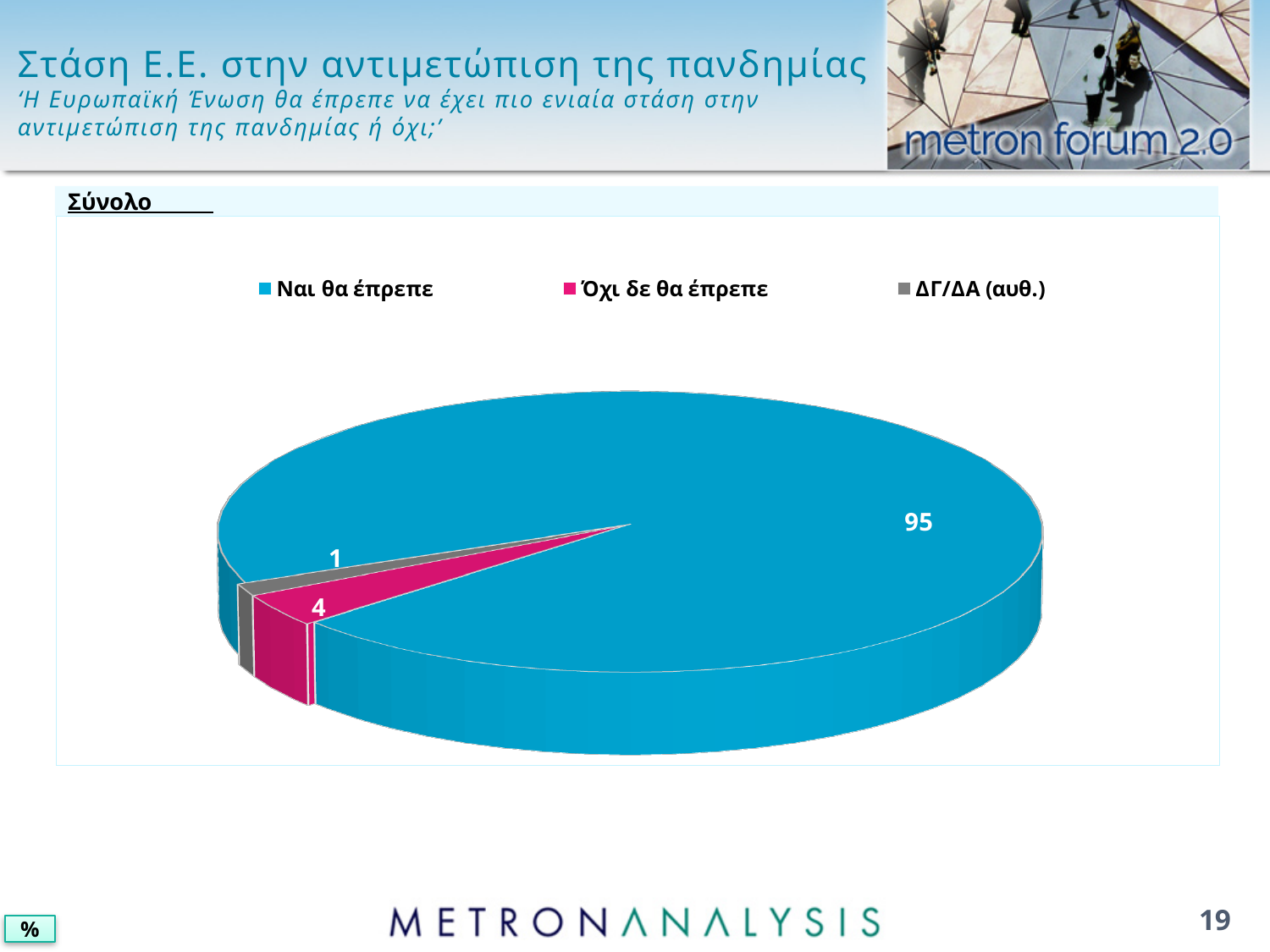
What is the value for 'Ναι θα έπρεπε' in the pie chart? 95 What is the value for 'Όχι δε θα έπρεπε' in the pie chart? 4 What is the difference between the values for 'Ναι θα έπρεπε' and 'Όχι δε θα έπρεπε'? 91 What is the difference between the values for 'Όχι δε θα έπρεπε' and 'ΔΓ/ΔΑ (αυθ.)'? 3 How many entries does the legend of the pie chart list? 3 Which category has the largest slice in the pie chart? Ναι θα έπρεπε How many slices does the pie chart have? 3 Which is larger: the value for 'Όχι δε θα έπρεπε' or the value for 'ΔΓ/ΔΑ (αυθ.)'? Όχι δε θα έπρεπε Which category has the smallest slice in the pie chart? ΔΓ/ΔΑ (αυθ.) What type of chart is shown on the slide? pie chart What is the heading shown above the pie chart? Σύνολο What is the value for 'ΔΓ/ΔΑ (αυθ.)' in the pie chart? 1